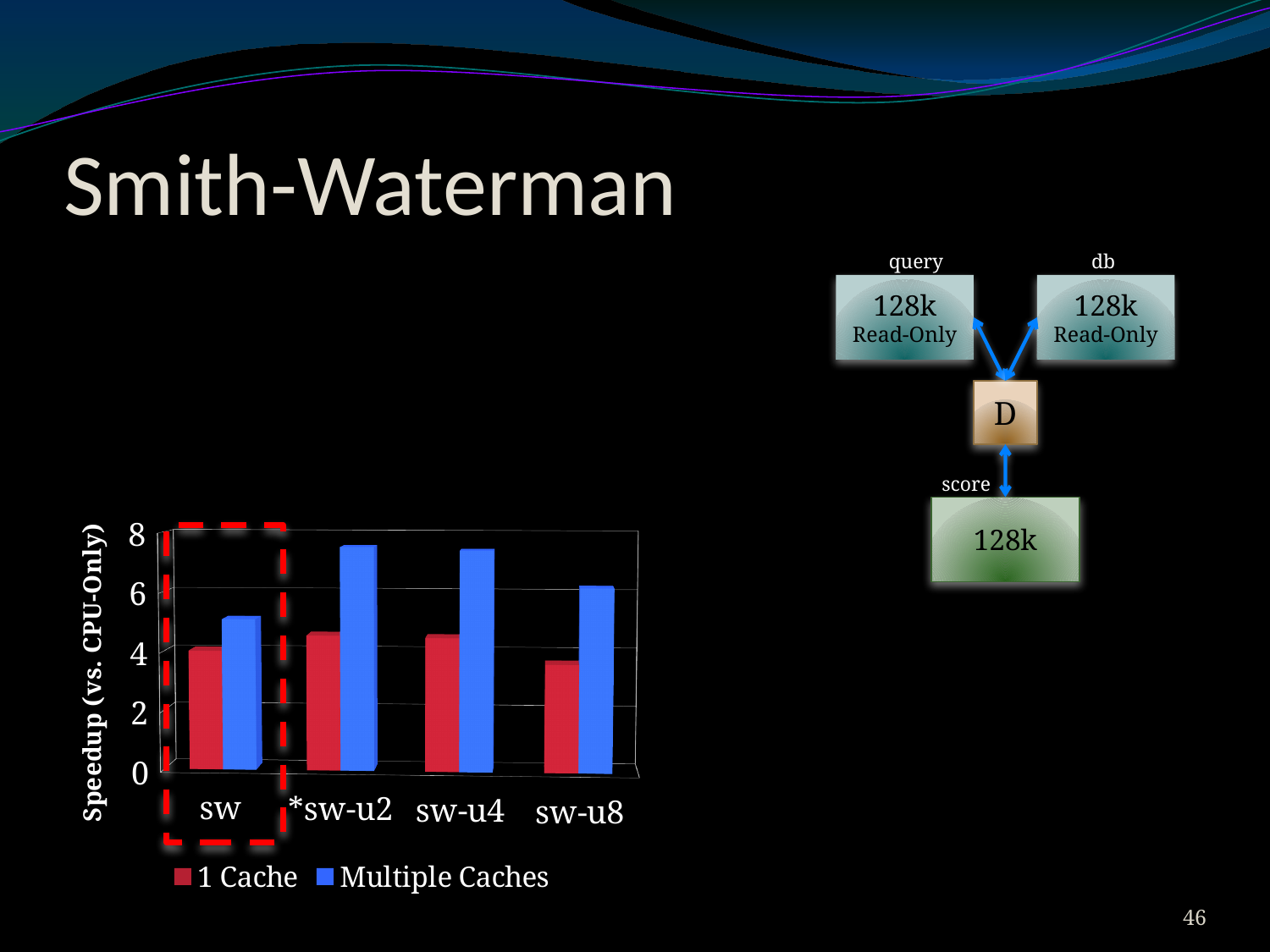
Which category has the lowest 1 Cache value? sw-u8 Which category has the lowest Multiple Caches value? sw How many series does the chart's legend list? 2 Which category on the chart is outlined with a red dashed box? sw What kind of chart is shown on the slide? bar chart What is the title of the chart's vertical axis? Speedup (vs. CPU-Only) Is the Multiple Caches value for sw greater or less than 6? less For the sw-u8 category, which series has the larger value: 1 Cache or Multiple Caches? Multiple Caches For the sw category, which series has the larger value: 1 Cache or Multiple Caches? Multiple Caches How many categories are shown on the x axis of the chart? 4 Is the 1 Cache value for sw-u8 greater or less than 4? less Is the Multiple Caches value for *sw-u2 greater or less than 6? greater